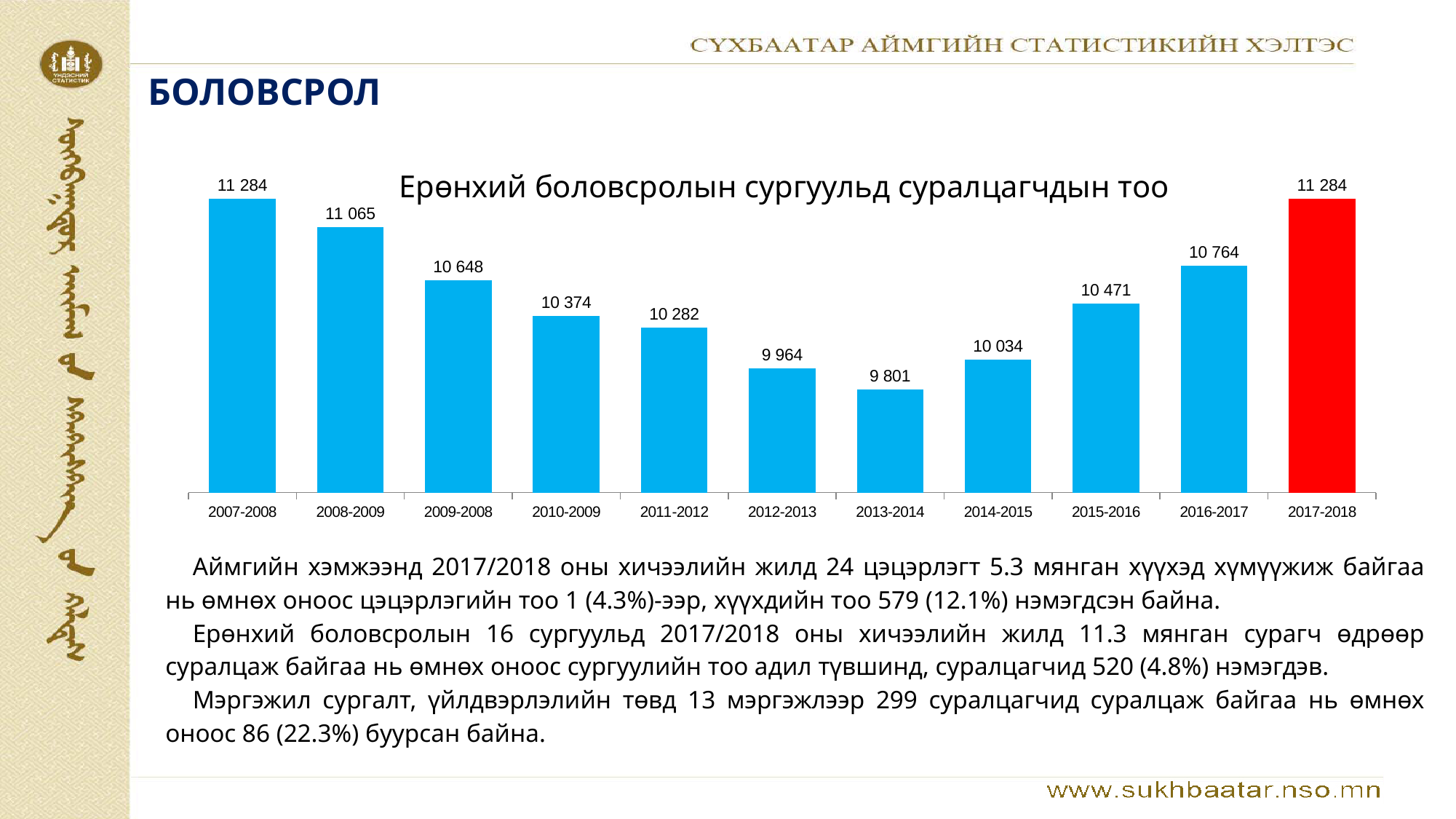
What is the difference between the values for 2012-2013 and 2013-2014? 163 Which is larger, the value for 2008-2009 or the value for 2016-2017? 2008-2009 What is the value for 2013-2014 in the chart? 9 801 Which is larger, the value for 2014-2015 or the value for 2010-2009? 2010-2009 Which bar in the chart is coloured red? 2017-2018 What is the value for 2015-2016 in the chart? 10 471 What is the difference between the values for 2017-2018 and 2016-2017? 520 Which school year has the lowest value in the chart? 2013-2014 What kind of chart is shown on the slide? Bar chart Do the values fall or rise from 2007-2008 to 2013-2014? Fall What is the value for 2011-2012 in the chart? 10 282 How many school years are shown on the x axis of the chart? 11